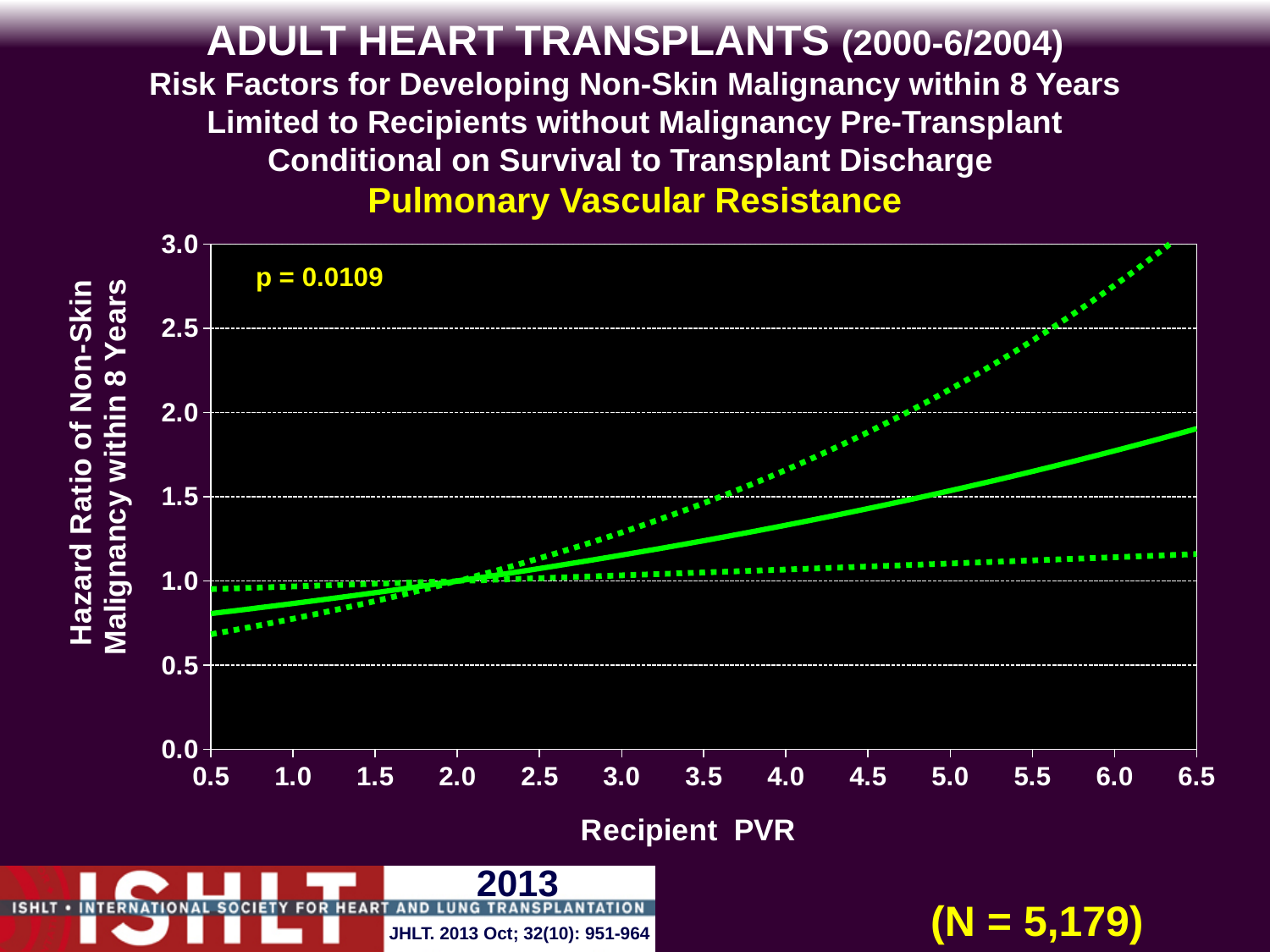
Does the solid hazard ratio line rise or fall as Recipient PVR increases from 0.5 to 6.5? rise Is the value of the lower dotted line at a Recipient PVR of 6.5 greater or less than 1.5? less Is the value of the upper dotted line at a Recipient PVR of 5.5 greater or less than 2.0? greater Is the value of the lower dotted line at a Recipient PVR of 0.5 greater or less than 0.5? greater How many lines are plotted on the chart? 3 What kind of chart is shown on the slide? line chart What is the highest value shown on the y axis of the chart? 3.0 What p-value is printed on the chart? p = 0.0109